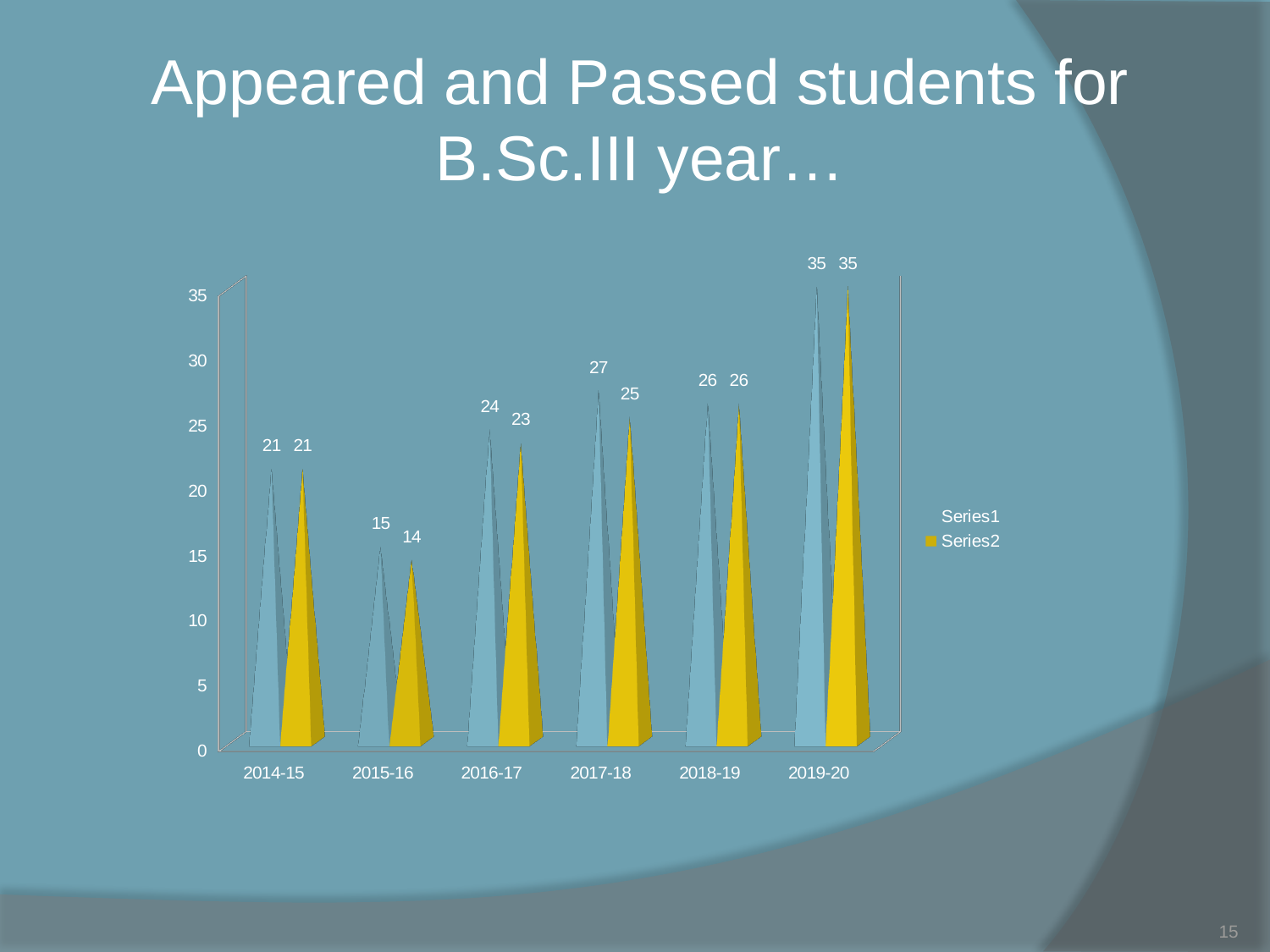
What is the difference between the Series1 and Series2 values for 2017-18? 2 What is the difference between the Series1 value for 2019-20 and the Series1 value for 2015-16? 20 Which is larger, the Series1 value for 2016-17 or the Series1 value for 2018-19? 2018-19 How many years are shown on the x axis? 6 Which year has the highest Series1 value? 2019-20 What is the Series2 value for 2016-17? 23 What is the title of the slide? Appeared and Passed students for B.Sc.III year… How many series does the legend list? 2 What is the Series2 value for 2015-16? 14 What kind of chart is shown on the slide? bar chart What is the Series1 value for 2017-18? 27 Which year has the lowest Series2 value? 2015-16